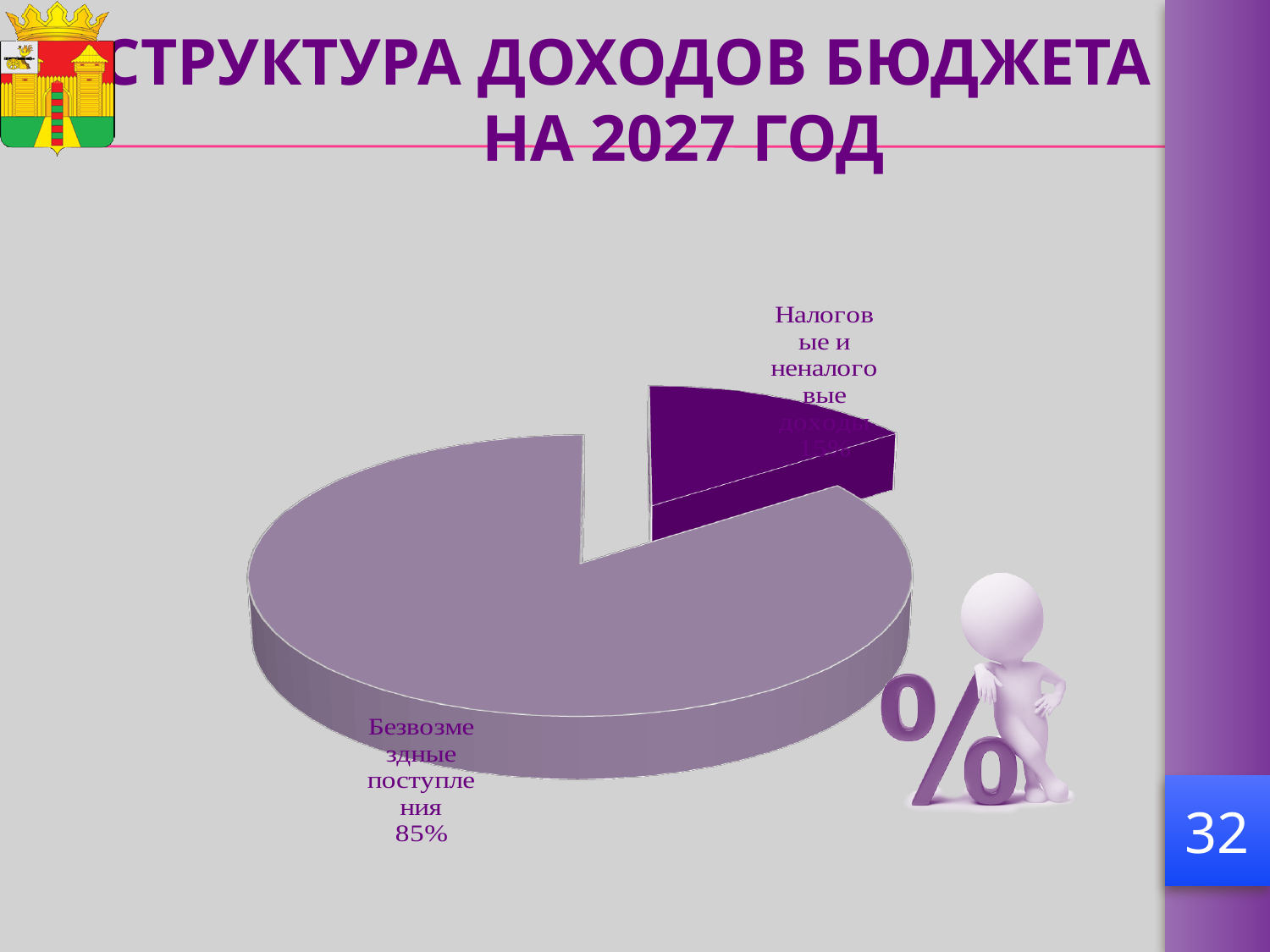
What is the title of the slide containing the pie chart? СТРУКТУРА ДОХОДОВ БЮДЖЕТА НА 2027 ГОД How many slices does the pie chart have? 2 Which is larger: the slice for "Безвозмездные поступления" or the slice for "Налоговые и неналоговые доходы"? Безвозмездные поступления Which slice of the pie is pulled out (exploded) from the rest of the pie? Налоговые и неналоговые доходы Which slice of the pie is the largest? Безвозмездные поступления Which slice of the pie is the smallest? Налоговые и неналоговые доходы What kind of chart is shown on the slide? Pie chart What share of the pie does the slice "Безвозмездные поступления" represent? 85%